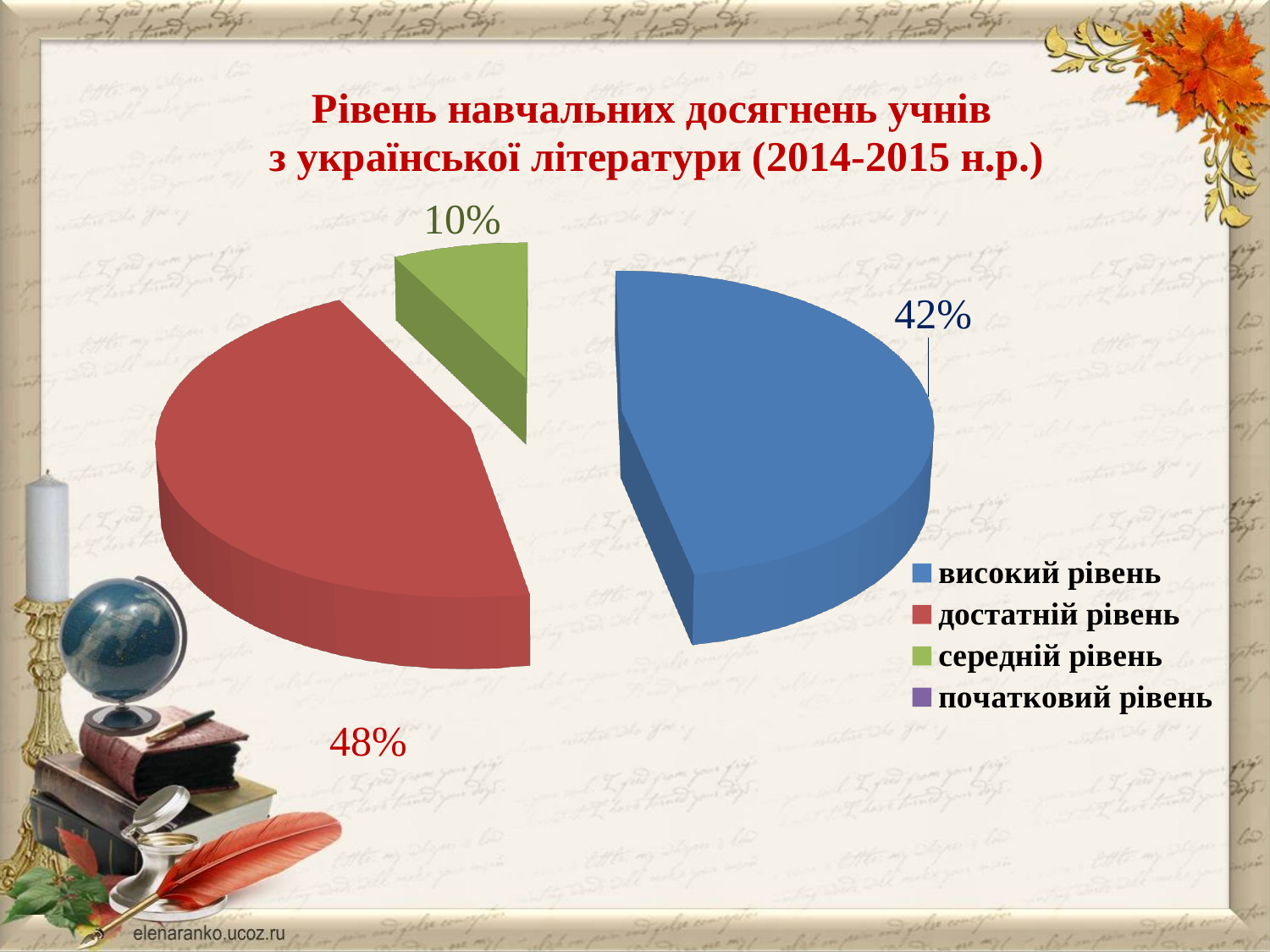
What percentage is shown for достатній рівень? 48% How many slices are visible in the pie? 3 What colour is the slice for достатній рівень? red Which level has the largest slice of the pie? достатній рівень Which is larger, the slice for високий рівень or the slice for середній рівень? високий рівень What percentage is shown for високий рівень? 42% How many entries does the legend list? 4 Of the three slices shown in the pie, which is the smallest? середній рівень By how many percentage points does достатній рівень exceed високий рівень? 6 percentage points What percentage is shown for середній рівень? 10% What type of chart is shown on the slide? pie chart Which school year does the chart title refer to? 2014-2015 н.р.